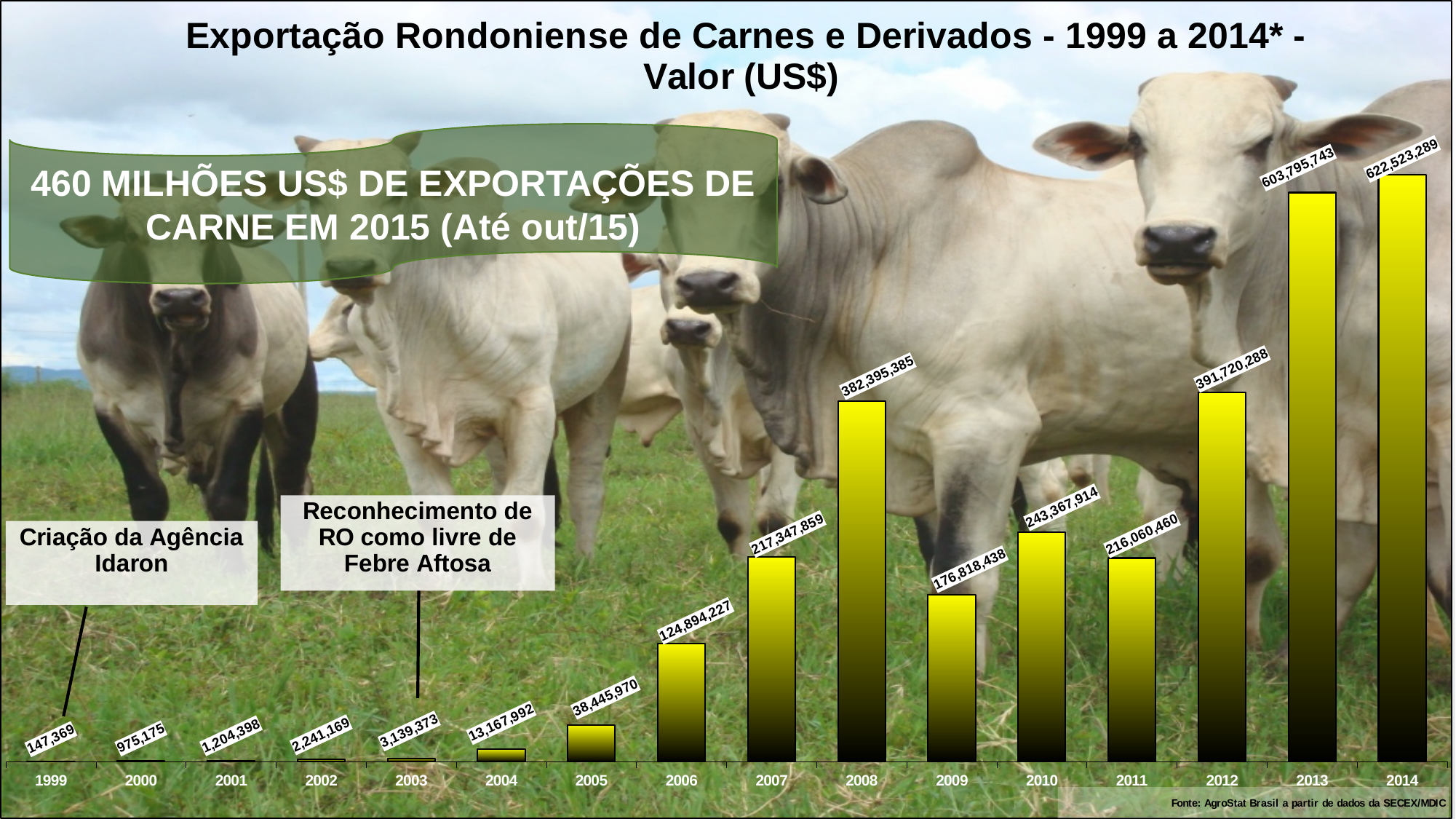
What is the export value for 2005? 38,445,970 Which year has the highest export value? 2014 What is the export value for 1999? 147,369 What is the title of the chart? Exportação Rondoniense de Carnes e Derivados - 1999 a 2014* - Valor (US$) Which year has the lowest export value? 1999 Which year has the larger export value, 2010 or 2011? 2010 How many years are shown on the x axis of the chart? 16 What is the difference between the export values for 2008 and 2009? 205,576,947 What is the export value for 2012? 391,720,288 What is the export value for 2008? 382,395,385 What is the difference between the export values for 2014 and 2013? 18,727,546 What kind of chart is shown on the slide? Bar chart